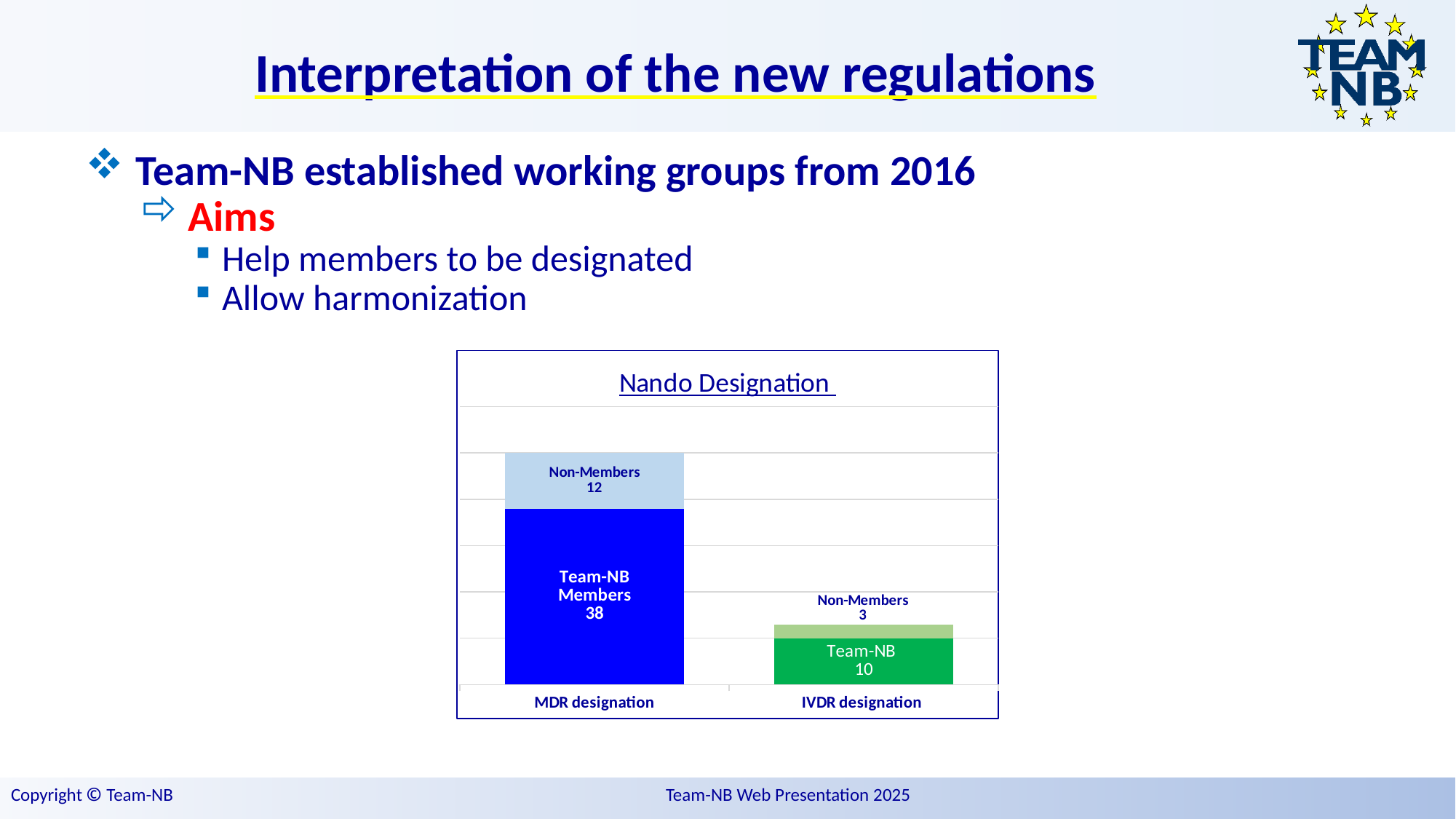
What is the difference between Non-Members for MDR designation and Non-Members for IVDR designation? 9 What is the title of the chart? Nando Designation How many categories are shown on the x axis of the chart? 2 How many Team-NB Members are shown for MDR designation? 38 What is the total of the IVDR designation bar? 13 What type of chart is shown on the slide? stacked bar chart How many Non-Members are shown for IVDR designation? 3 Which category has the taller stacked bar, MDR designation or IVDR designation? MDR designation How many Team-NB members are shown for IVDR designation? 10 What is the difference between Team-NB Members for MDR designation and Team-NB for IVDR designation? 28 What is the total of the MDR designation bar? 50 How many Non-Members are shown for MDR designation? 12